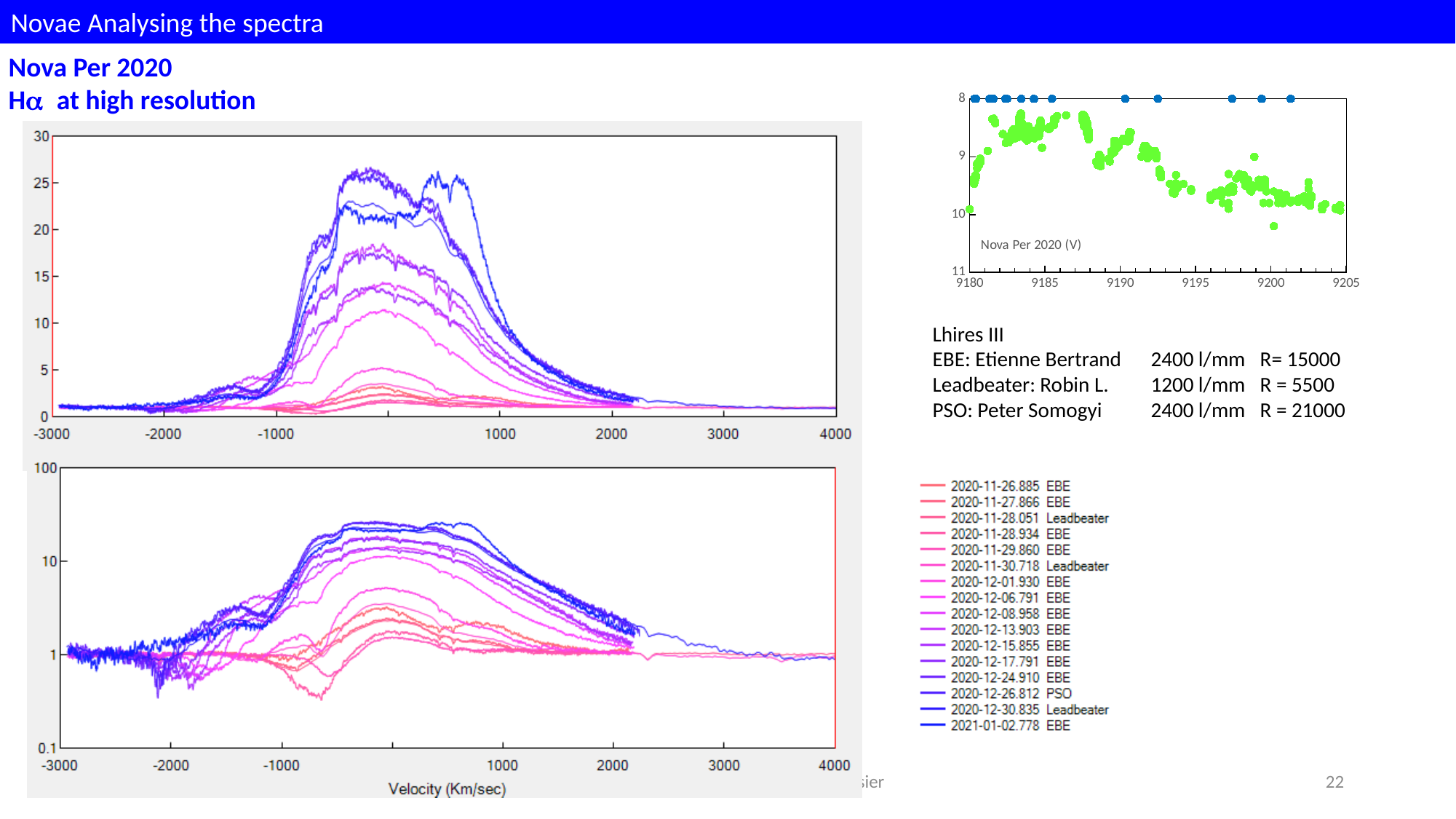
What kind of chart is the top-left chart showing the H-alpha profiles? line chart What is the x-axis label of the bottom-left chart? Velocity (Km/sec) What is the title printed inside the top-right chart? Nova Per 2020 (V) What is the lowest value shown on the y-axis of the bottom-left chart? 0.1 What is the maximum value shown on the y-axis of the top-left chart? 30 In the top-left chart, is the peak value of the highest curve greater or less than 20? greater How many legend entries are attributed to PSO? 1 What is the date of the first entry in the legend? 2020-11-26.885 How many spectra (series) does the legend on the right list? 16 How many legend entries are attributed to Leadbeater? 3 What kind of chart is the top-right chart titled 'Nova Per 2020 (V)'? scatter chart In the top-left chart, is the peak value of the lowest (red) curve greater or less than 5? less